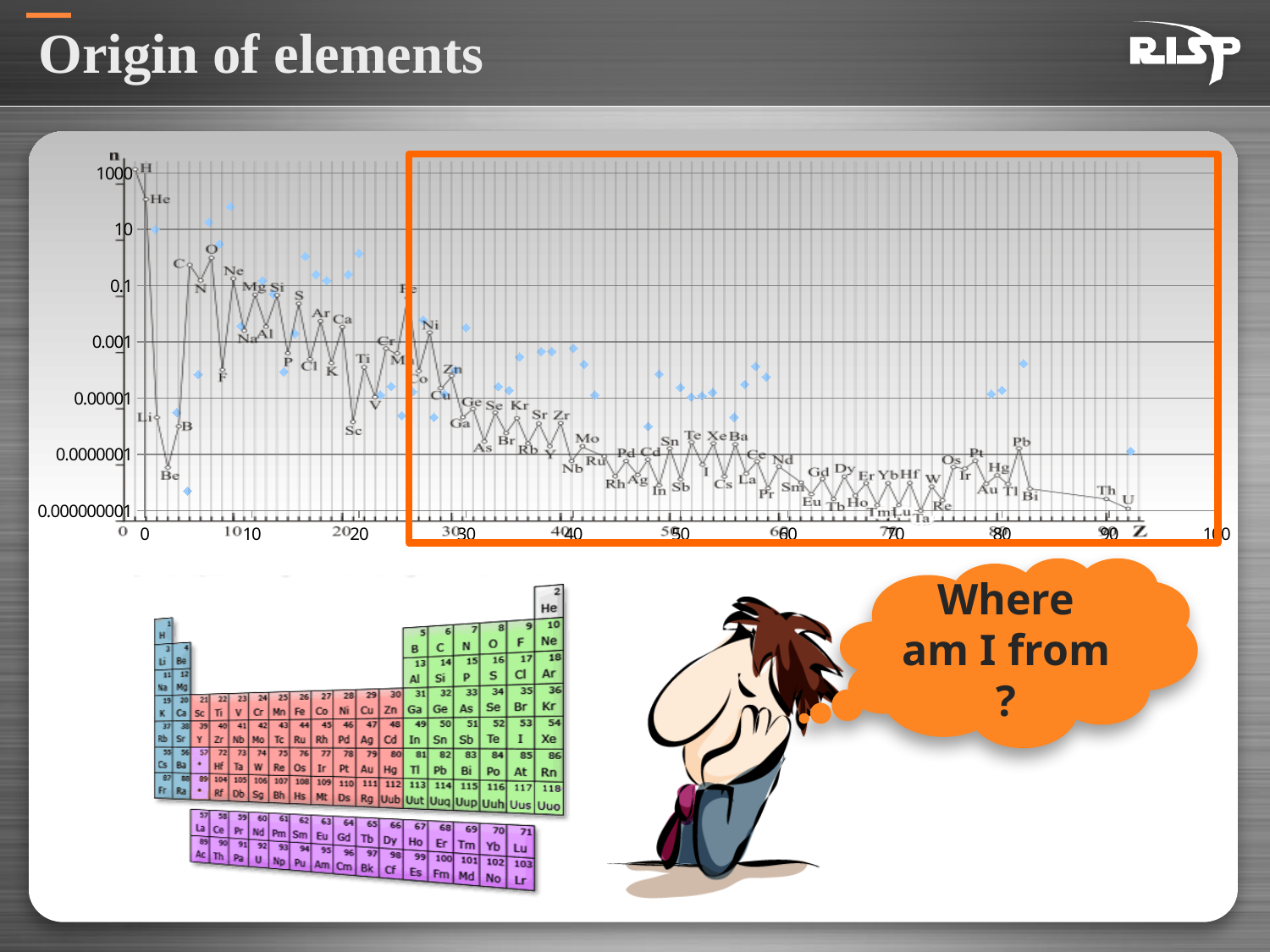
What is the label on the x axis of the chart? Z Is the value for Li greater or less than 0.00001? less Which has the larger value, Fe or Ni? Fe Overall, do the values rise or fall as Z increases along the x axis? fall Is the value for O greater or less than 0.1? greater Which has the larger value, Li or Be? Li What kind of chart is shown on the slide? line chart Is the value for U greater or less than 0.0000001? less Which element has the highest value on the chart? H Which has the larger value, H or He? H